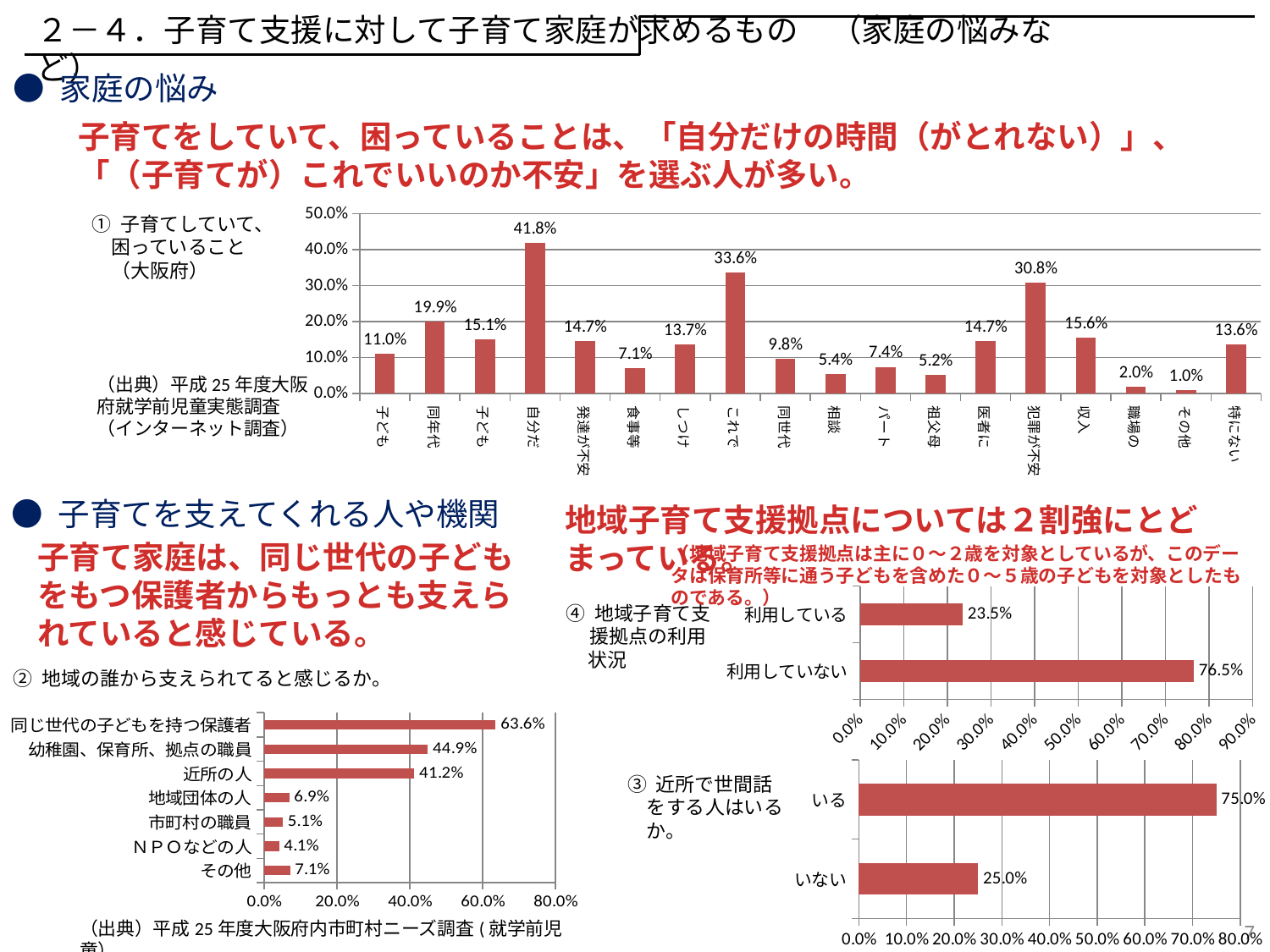
In chart ① 子育てしていて、困っていること（大阪府）, how many bars are shown? 18 In chart ② 地域の誰から支えられてると感じるか, what is the value for 同じ世代の子どもを持つ保護者? 63.6% In chart ② 地域の誰から支えられてると感じるか, which category has the lowest value? ＮＰＯなどの人 In chart ② 地域の誰から支えられてると感じるか, how many categories are shown? 7 In chart ② 地域の誰から支えられてると感じるか, what is the difference between 幼稚園、保育所、拠点の職員 and 近所の人? 3.7% In chart ④ 地域子育て支援拠点の利用状況, what is the difference between 利用していない and 利用している? 53.0% In chart ① 子育てしていて、困っていること（大阪府）, what is the value for その他? 1.0% What kind of chart is chart ③ 近所で世間話をする人はいるか? Bar chart In chart ④ 地域子育て支援拠点の利用状況, what is the value for 利用している? 23.5% In chart ③ 近所で世間話をする人はいるか, what is the value for いない? 25.0% In chart ② 地域の誰から支えられてると感じるか, which is larger, 地域団体の人 or その他? その他 In chart ① 子育てしていて、困っていること（大阪府）, what is the highest value shown? 41.8%